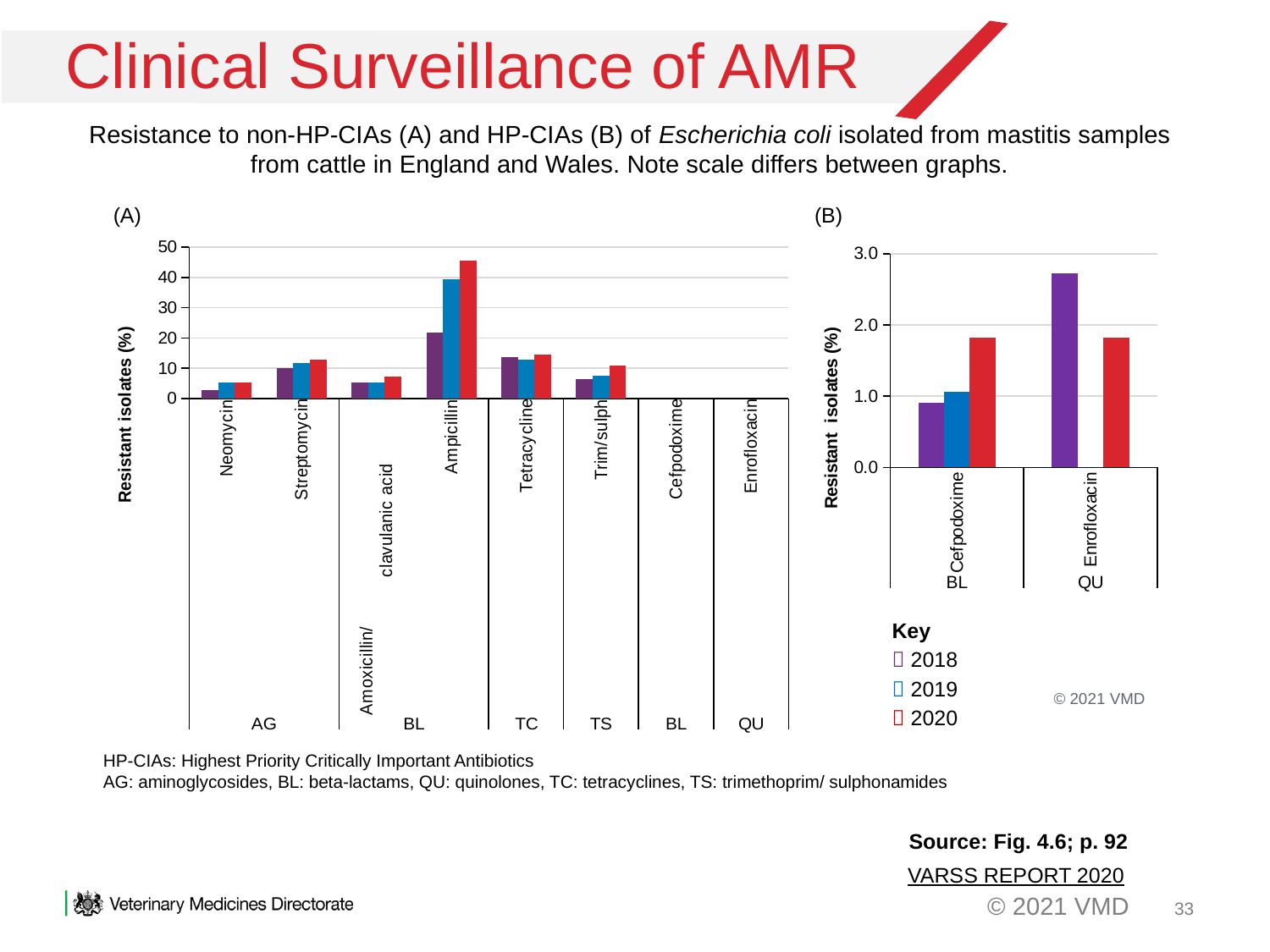
In chart (B), is the 2018 value for Enrofloxacin greater or less than 2.0? greater In chart (A), which antibiotic has the highest resistance value in 2020? Ampicillin In chart (B), which antibiotic has the highest value in 2018? Enrofloxacin In chart (A), do the values for Ampicillin rise or fall from 2018 to 2020? rise How many antibiotic categories are shown on the x axis of chart (A)? 8 Which colour represents 2020 in the key? red How many series does the key list for the charts? 3 In chart (A), which is larger in 2020: Ampicillin or Tetracycline? Ampicillin What kind of chart is chart (A)? bar chart In chart (A), is the 2018 value for Neomycin greater or less than 10? less How many antibiotic categories are shown on the x axis of chart (B)? 2 In chart (A), is the 2020 value for Ampicillin greater or less than 40? greater